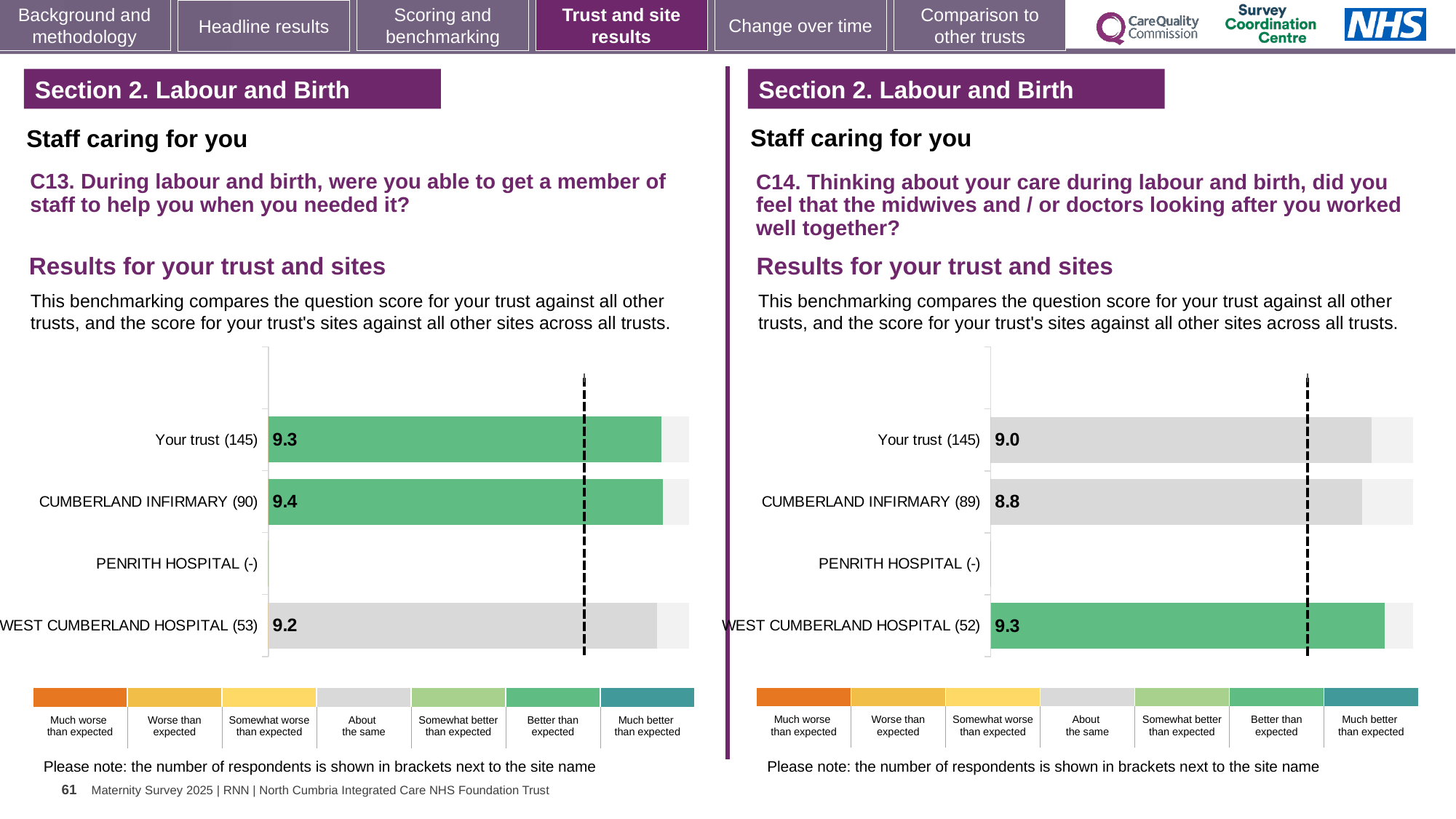
In the C14 chart on the right, what is the score for WEST CUMBERLAND HOSPITAL? 9.3 In the C13 chart on the left, what is the score for CUMBERLAND INFIRMARY? 9.4 In the C14 chart on the right, what is the score for Your trust? 9.0 In the C14 chart on the right, which is larger: the score for Your trust or the score for CUMBERLAND INFIRMARY? Your trust In the C13 chart on the left, what is the score for Your trust? 9.3 In the C13 chart on the left, what is the difference between the CUMBERLAND INFIRMARY score and the WEST CUMBERLAND HOSPITAL score? 0.2 In the C13 chart on the left, what is the score for WEST CUMBERLAND HOSPITAL? 9.2 In the C13 chart on the left, how many respondents are shown in brackets for CUMBERLAND INFIRMARY? 90 In the C14 chart on the right, which site has the highest score? WEST CUMBERLAND HOSPITAL What kind of chart is used in the C13 chart on the left? Bar chart In the C14 chart on the right, which site has the lowest score? CUMBERLAND INFIRMARY In the C14 chart on the right, what is the score for CUMBERLAND INFIRMARY? 8.8